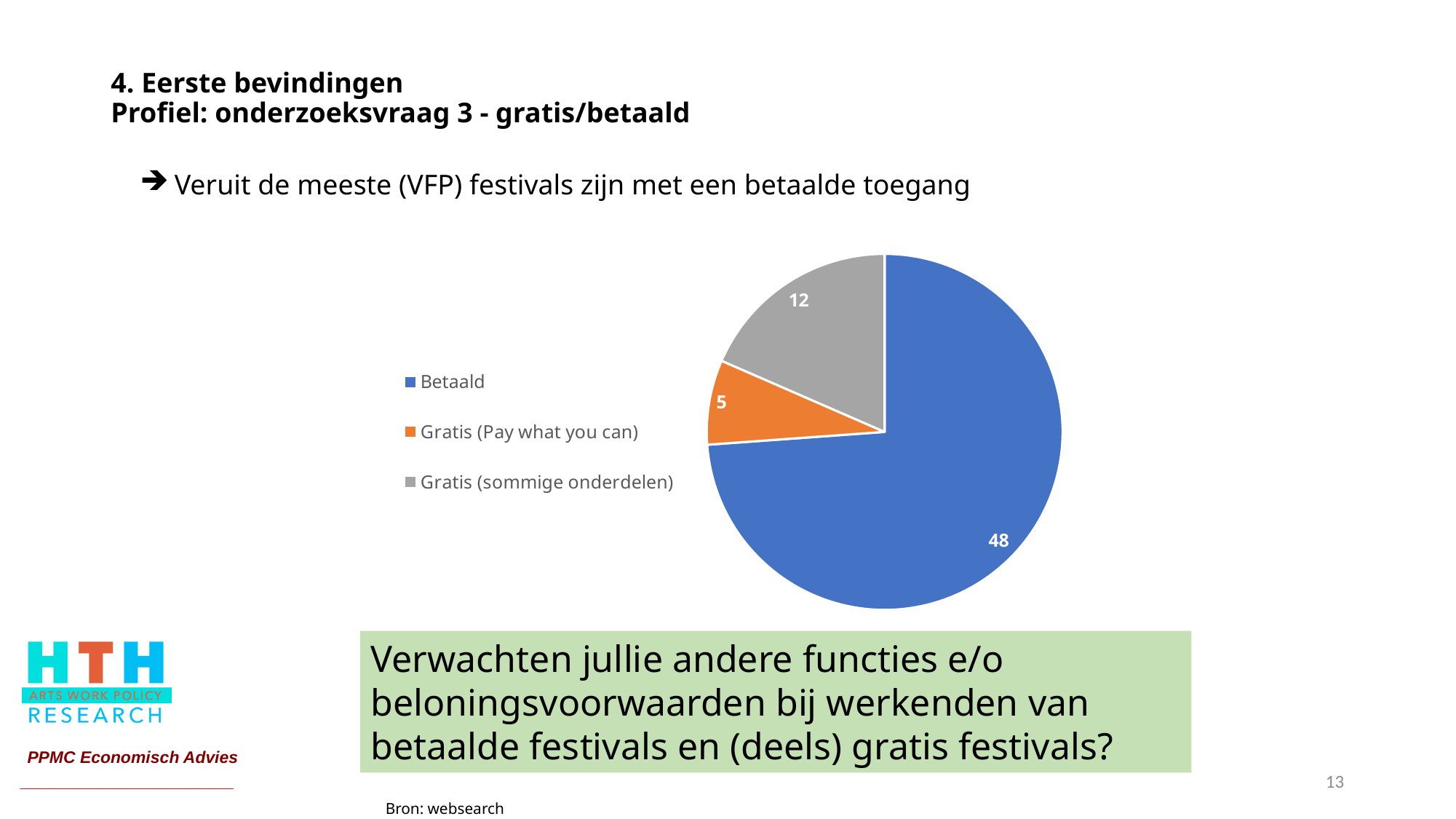
What colour is the Betaald slice in the pie chart? blue Which is larger: Gratis (sommige onderdelen) or Gratis (Pay what you can)? Gratis (sommige onderdelen) Which category has the largest slice in the pie chart? Betaald What is the difference between the values for Betaald and Gratis (sommige onderdelen)? 36 What type of chart is shown on the slide? pie chart Which category has the smallest slice in the pie chart? Gratis (Pay what you can) How many categories does the pie chart show? 3 What is the total of all slices in the pie chart? 65 What is the value for Gratis (Pay what you can) in the pie chart? 5 What is the value for Gratis (sommige onderdelen) in the pie chart? 12 What is the difference between the values for Gratis (sommige onderdelen) and Gratis (Pay what you can)? 7 What is the value for Betaald in the pie chart? 48